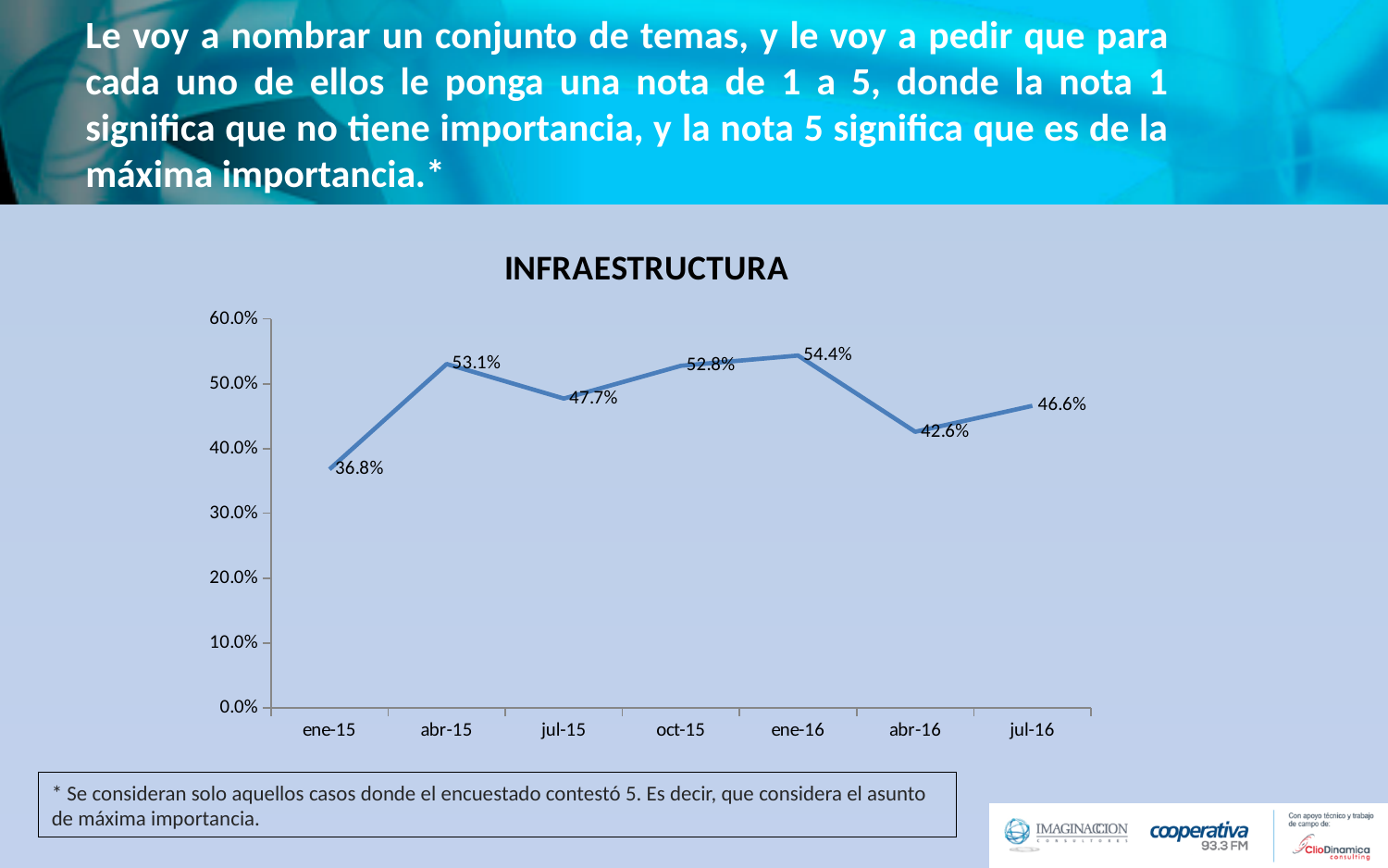
What is the value for abr-16 in the INFRAESTRUCTURA chart? 42.6% What is the title of the chart on the slide? INFRAESTRUCTURA What is the value for jul-16 in the INFRAESTRUCTURA chart? 46.6% Is the value for abr-16 in the INFRAESTRUCTURA chart greater or less than 50.0%? less How many time periods are plotted in the INFRAESTRUCTURA chart? 7 Which period has the highest value in the INFRAESTRUCTURA chart? ene-16 What is the difference between the values for ene-16 and abr-16 in the INFRAESTRUCTURA chart? 11.8% What is the difference between the values for abr-15 and ene-15 in the INFRAESTRUCTURA chart? 16.3% What kind of chart is shown on the slide? line chart Which period has the lowest value in the INFRAESTRUCTURA chart? ene-15 What is the value for ene-15 in the INFRAESTRUCTURA chart? 36.8% Which is larger in the INFRAESTRUCTURA chart, the value for jul-15 or the value for oct-15? oct-15